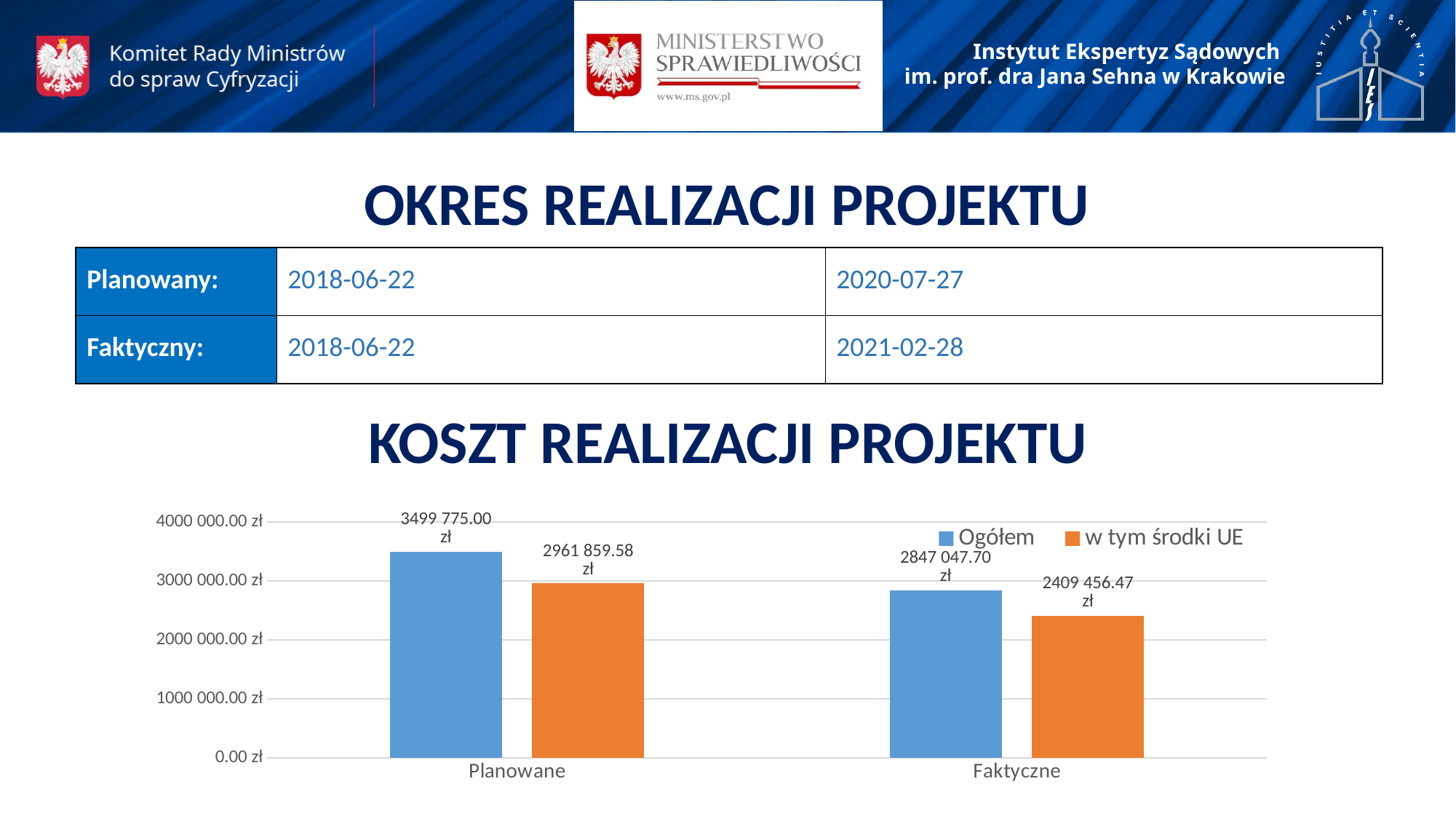
What is the 'Ogółem' value for 'Planowane'? 3499 775.00 zł What is the difference between the 'Ogółem' values for 'Planowane' and 'Faktyczne'? 652 727.30 zł Which bar in the chart has the highest value? Planowane, Ogółem How many categories are shown on the x axis of the chart? 2 What is the 'w tym środki UE' value for 'Faktyczne'? 2409 456.47 zł What is the 'w tym środki UE' value for 'Planowane'? 2961 859.58 zł What is the 'Ogółem' value for 'Faktyczne'? 2847 047.70 zł What is the difference between 'Ogółem' and 'w tym środki UE' for 'Faktyczne'? 437 591.23 zł How many series does the chart legend list? 2 Which bar in the chart has the lowest value? Faktyczne, w tym środki UE What type of chart is shown under 'KOSZT REALIZACJI PROJEKTU'? bar chart Is the 'Ogółem' value for 'Planowane' or for 'Faktyczne' larger? Planowane